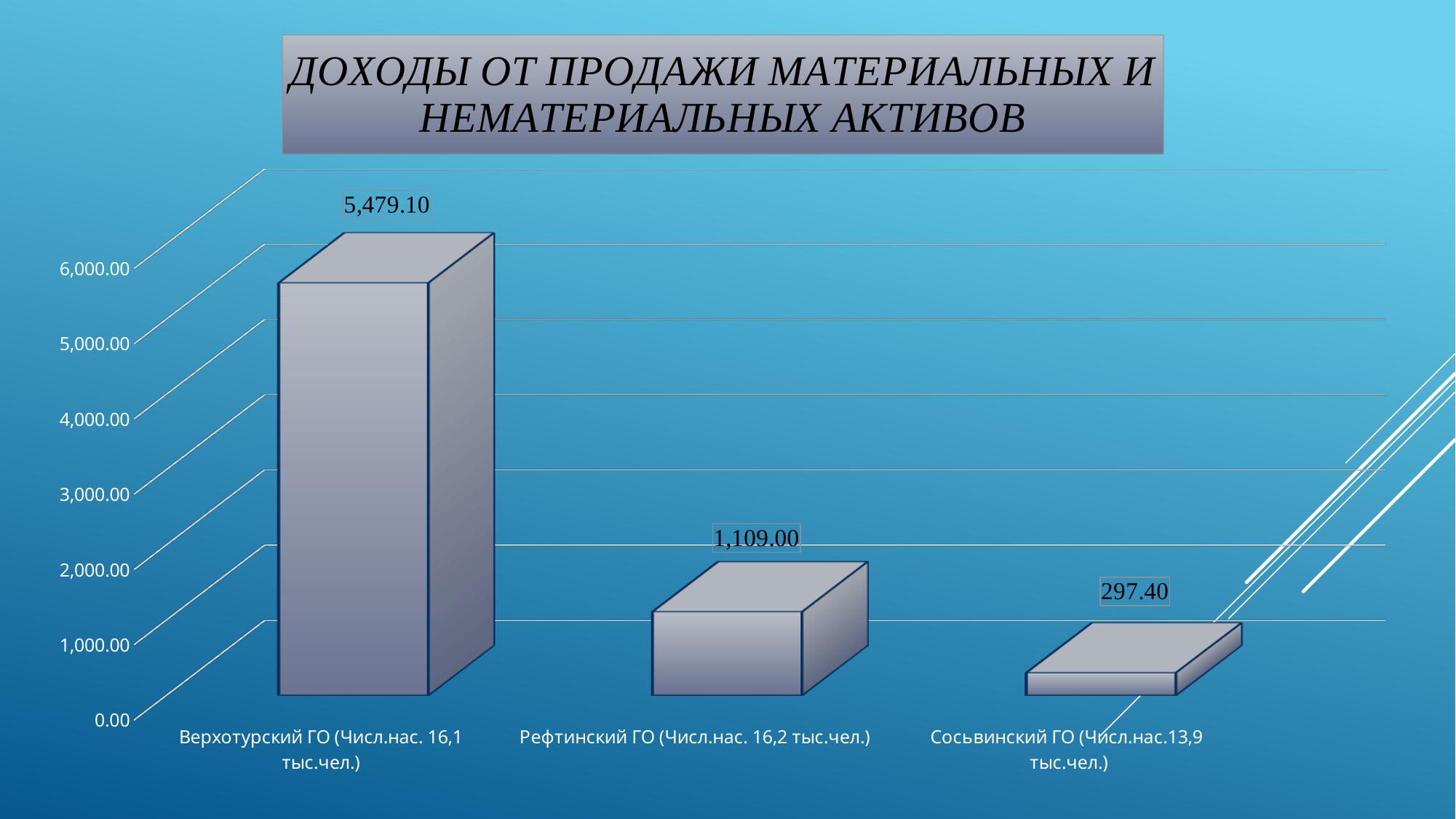
What kind of chart is shown on the slide? bar chart Which is larger, the value for Рефтинский ГО or the value for Сосьвинский ГО? Рефтинский ГО Is the value for Верхотурский ГО greater or less than 5,000.00? greater What is the difference between the values for Рефтинский ГО and Сосьвинский ГО? 811.60 What is the value for Верхотурский ГО? 5,479.10 Which category has the highest value? Верхотурский ГО What is the title of the chart? ДОХОДЫ ОТ ПРОДАЖИ МАТЕРИАЛЬНЫХ И НЕМАТЕРИАЛЬНЫХ АКТИВОВ What is the value for Сосьвинский ГО? 297.40 How many categories are shown on the chart? 3 Which category has the lowest value? Сосьвинский ГО What is the value for Рефтинский ГО? 1,109.00 What is the difference between the values for Верхотурский ГО and Рефтинский ГО? 4,370.10